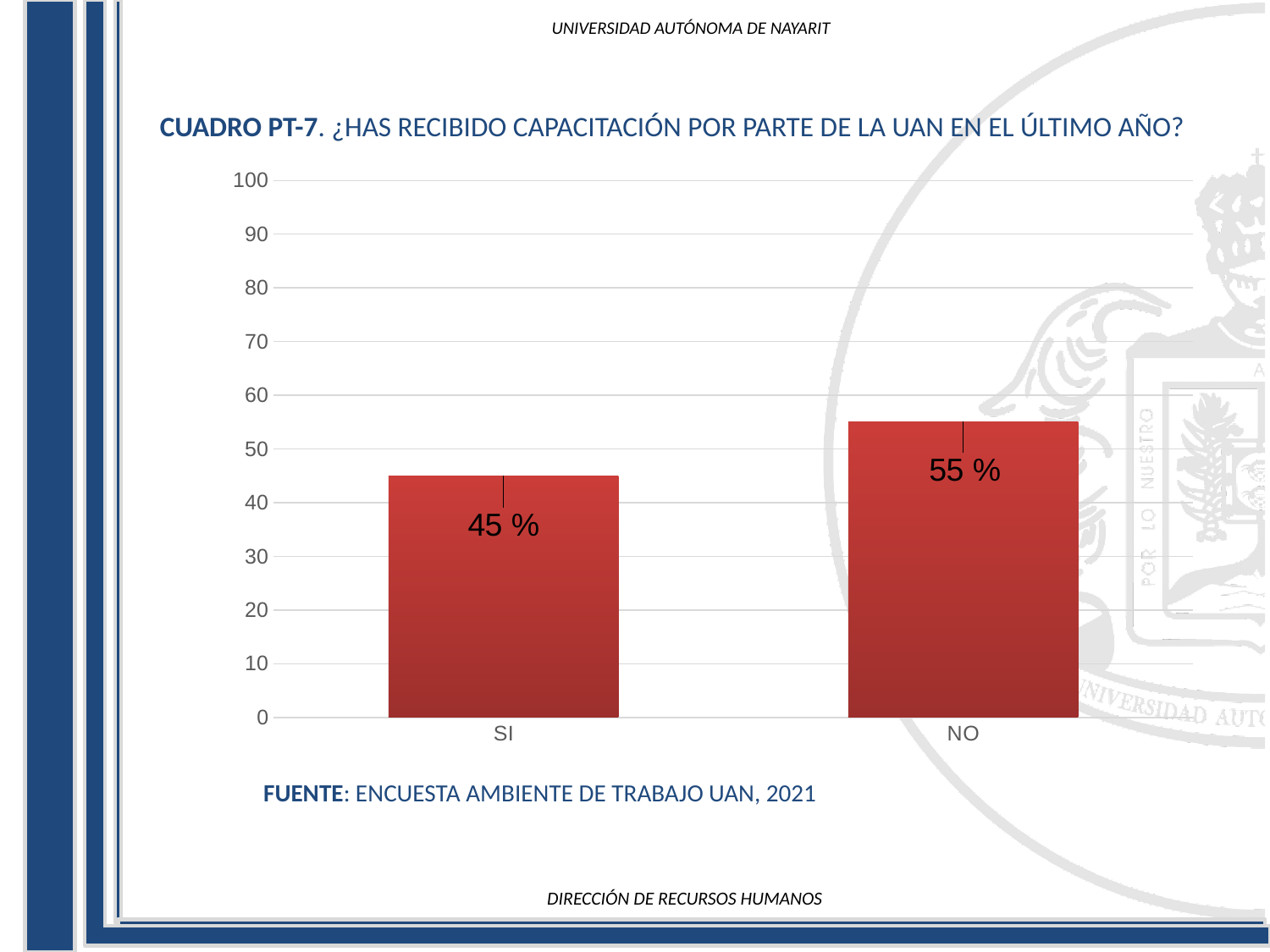
Which category has the lowest value? SI What is the value for SI? 45 % Is the value for NO greater or less than 50? greater What is the value for NO? 55 % What kind of chart is shown on the slide? bar chart Which category has the highest value? NO How many categories are shown on the x axis? 2 What source is cited below the chart? ENCUESTA AMBIENTE DE TRABAJO UAN, 2021 What is the highest value shown on the y axis? 100 What is the difference between the values for NO and SI? 10 % Is the value for SI greater or less than 50? less Which is larger, the value for SI or the value for NO? NO